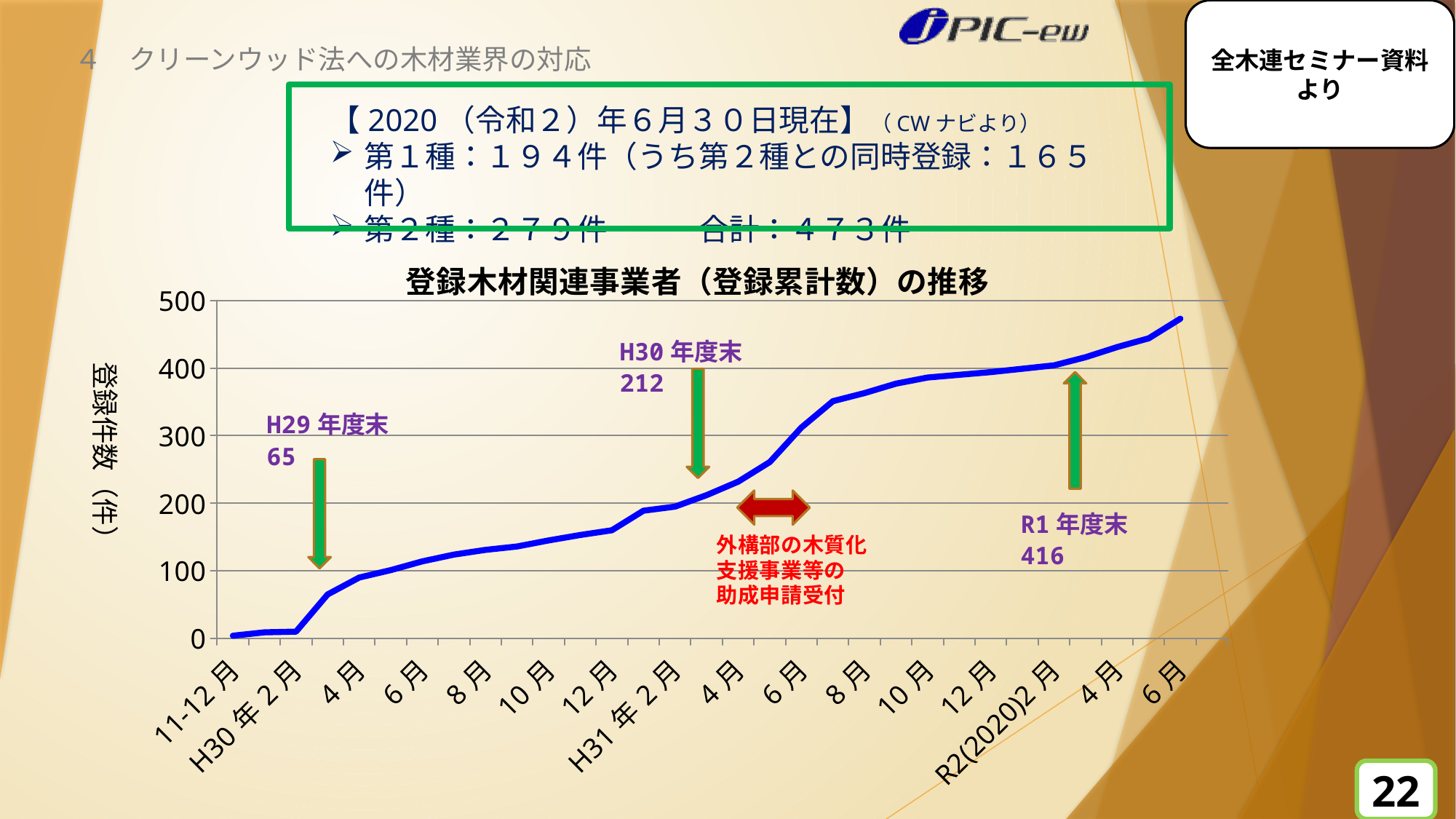
Is the value at 8月 of H30 greater or less than 200? less Is the value at 6月 of R2(2020) greater or less than 400? greater Does the line rise or fall as it moves from left to right along the x axis? rises What is the cumulative registration count at H29年度末 according to the chart annotation? 65 Which is larger, the value at H30年度末 or the value at R1年度末? R1年度末 What is the cumulative registration count at H30年度末 according to the chart annotation? 212 By how much did the cumulative count increase from H30年度末 to R1年度末? 204 By how much did the cumulative count increase from H29年度末 to H30年度末? 147 What is the label of the vertical axis of the chart? 登録件数（件） What is the cumulative registration count at R1年度末 according to the chart annotation? 416 What is the title of the chart? 登録木材関連事業者（登録累計数）の推移 What kind of chart is shown on the slide? line chart